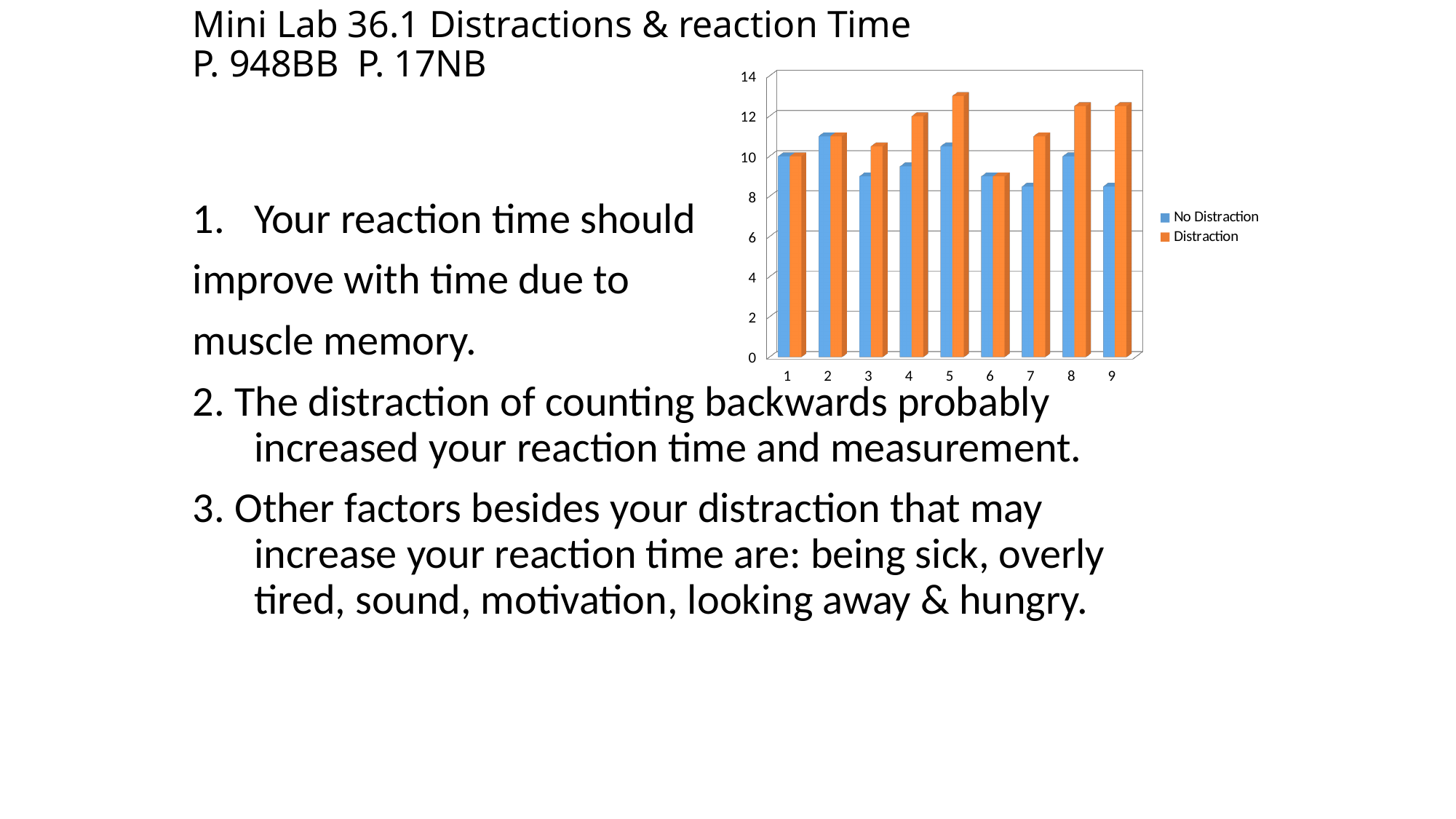
Is the Distraction value for category 5 greater or less than 12? greater What is the No Distraction value for category 8? 10 What is the Distraction value for category 4? 12 Which category has the highest Distraction value? 5 What is the No Distraction value for category 1? 10 What kind of chart is shown on the slide? bar chart Which colour represents the Distraction series in the chart? orange For category 4, which is larger: the Distraction value or the No Distraction value? Distraction What are the two series named in the chart's legend? No Distraction and Distraction How many series does the chart's legend list? 2 How many categories are shown along the x axis of the chart? 9 Is the No Distraction value for category 7 greater or less than 10? less